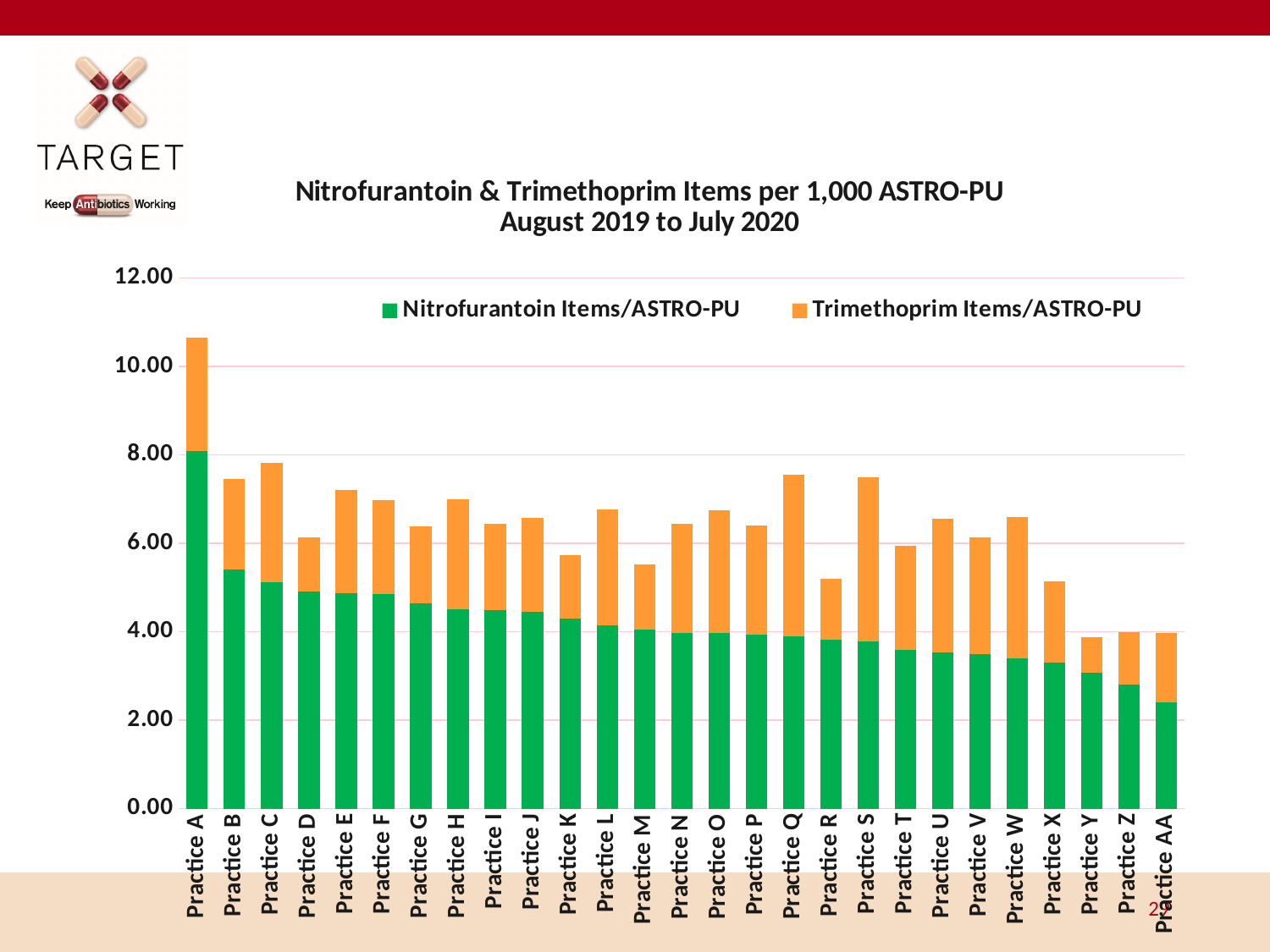
What kind of chart is shown on the slide? Stacked bar chart Is the total value for Practice S greater or less than 6.00? greater How many series does the legend list? 2 How many practices are shown on the x axis? 27 Is the Nitrofurantoin Items/ASTRO-PU value for Practice AA greater or less than 4.00? less Which practice has the highest total Nitrofurantoin & Trimethoprim items per 1,000 ASTRO-PU? Practice A Which practice has the highest Nitrofurantoin Items/ASTRO-PU value? Practice A Which practice has the lowest Nitrofurantoin Items/ASTRO-PU value? Practice AA Do the Nitrofurantoin Items/ASTRO-PU values generally rise or fall from Practice A to Practice AA? fall Which has the larger total value, Practice Q or Practice R? Practice Q Is the total value for Practice A greater or less than 10.00? greater What colour represents Trimethoprim Items/ASTRO-PU in the chart? Orange